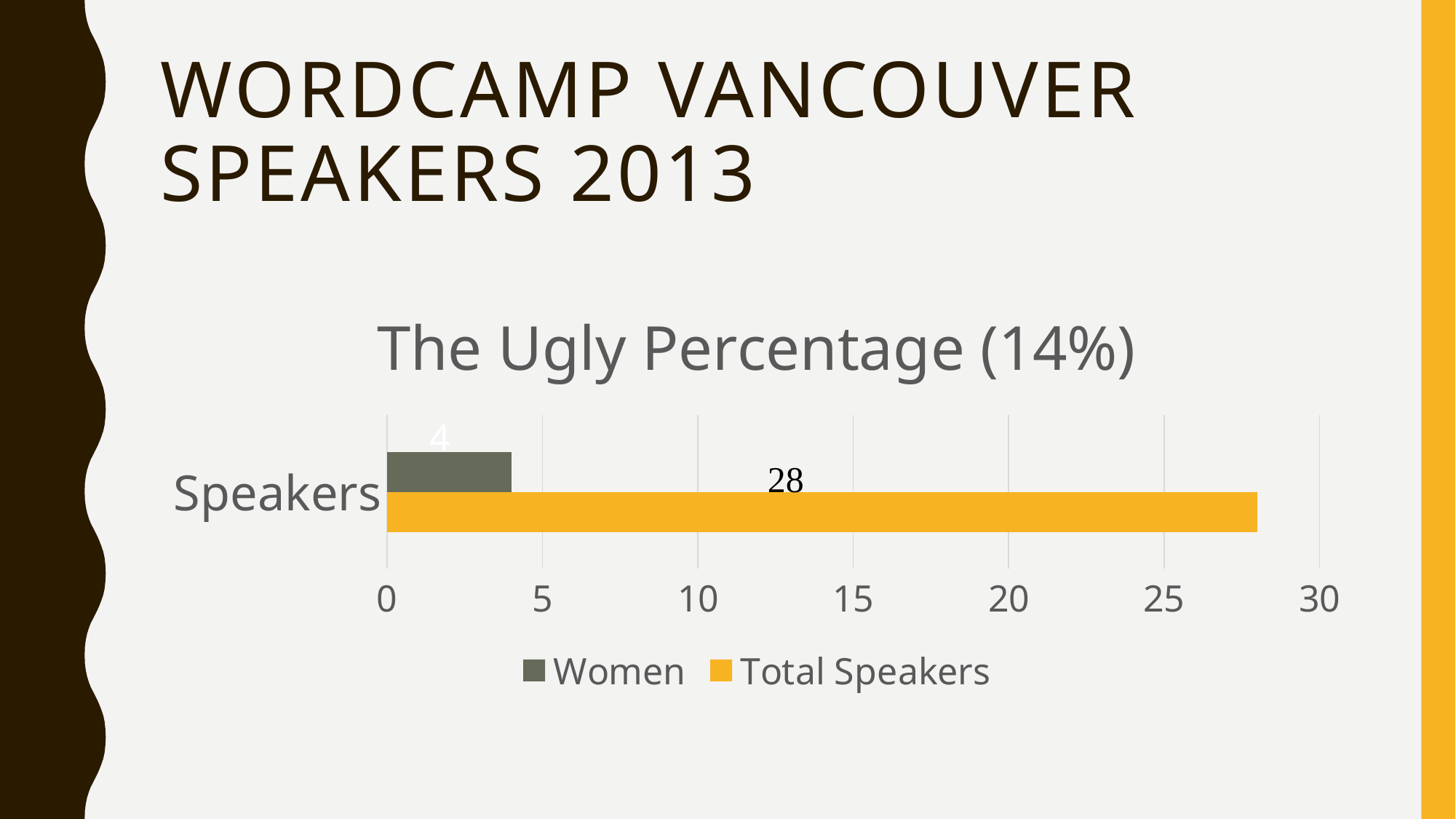
What is the highest value shown on the x axis? 30 Which series is shown in yellow? Total Speakers Is the value for Women greater or less than 5? less Which series has the higher value for Speakers, Women or Total Speakers? Total Speakers How many series does the legend list? 2 What kind of chart is shown on the slide? Bar chart What is the value for Women in the Speakers category? 4 What is the difference between the Total Speakers value and the Women value? 24 What is the value for Total Speakers in the Speakers category? 28 Is the value for Total Speakers greater or less than 25? greater What is the title of the chart? The Ugly Percentage (14%) How many categories are shown on the chart? 1